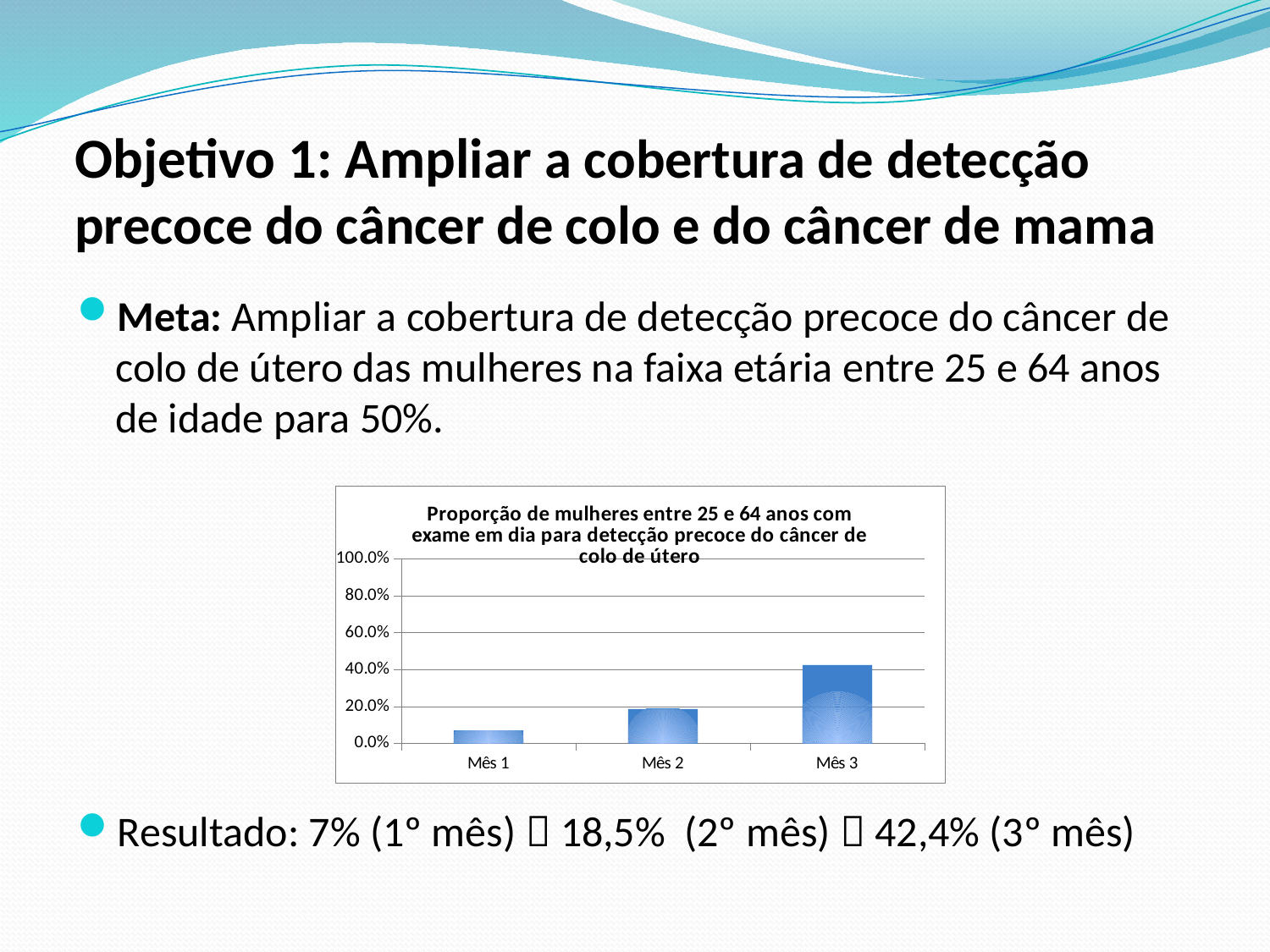
How many categories (months) are plotted in the chart? 3 Is the value for Mês 3 greater or less than 40.0%? greater Is the value for Mês 3 greater or less than 60.0%? less What kind of chart is shown on the slide? bar chart Which is larger, the value for Mês 2 or the value for Mês 3? Mês 3 Do the values rise or fall from Mês 1 to Mês 3? rise Which month has the lowest proportion in the chart? Mês 1 Which month has the highest proportion in the chart? Mês 3 Is the value for Mês 1 greater or less than 20.0%? less What is the title of the chart? Proporção de mulheres entre 25 e 64 anos com exame em dia para detecção precoce do câncer de colo de útero What is the highest tick value shown on the chart's vertical axis? 100.0%